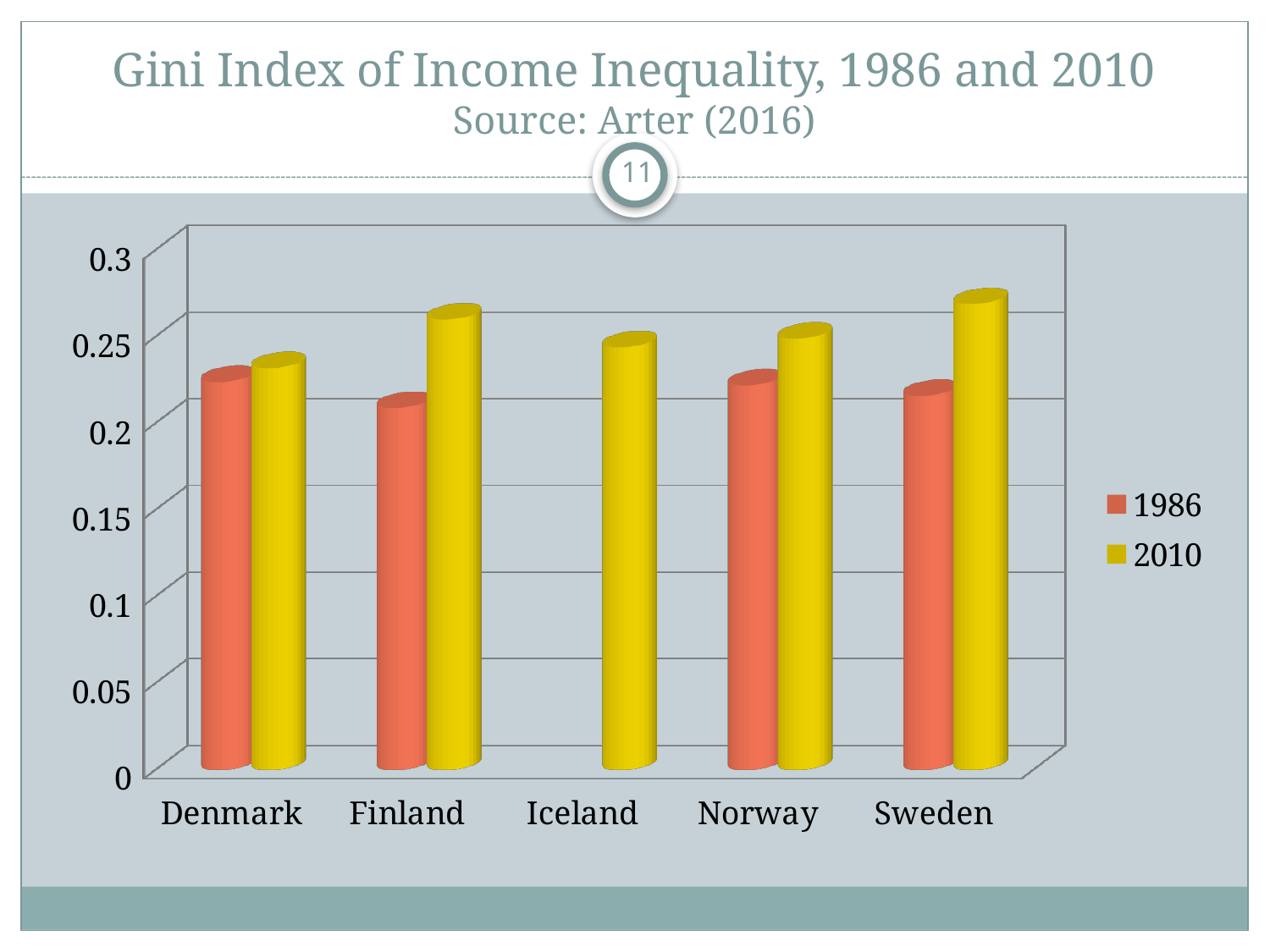
Which country has the highest Gini index value for 2010? Sweden What kind of chart is shown on the slide? Bar chart What is the title of the chart on the slide? Gini Index of Income Inequality, 1986 and 2010 Is the 2010 value for Denmark greater or less than 0.25? less How many series does the chart's legend list? 2 Is the 2010 value for Sweden greater or less than 0.25? greater How many countries are shown on the x axis of the chart? 5 Which country has no bar for 1986 in the chart? Iceland Is the 1986 value for Finland greater or less than 0.25? less For Finland, which is larger: the 1986 value or the 2010 value? 2010